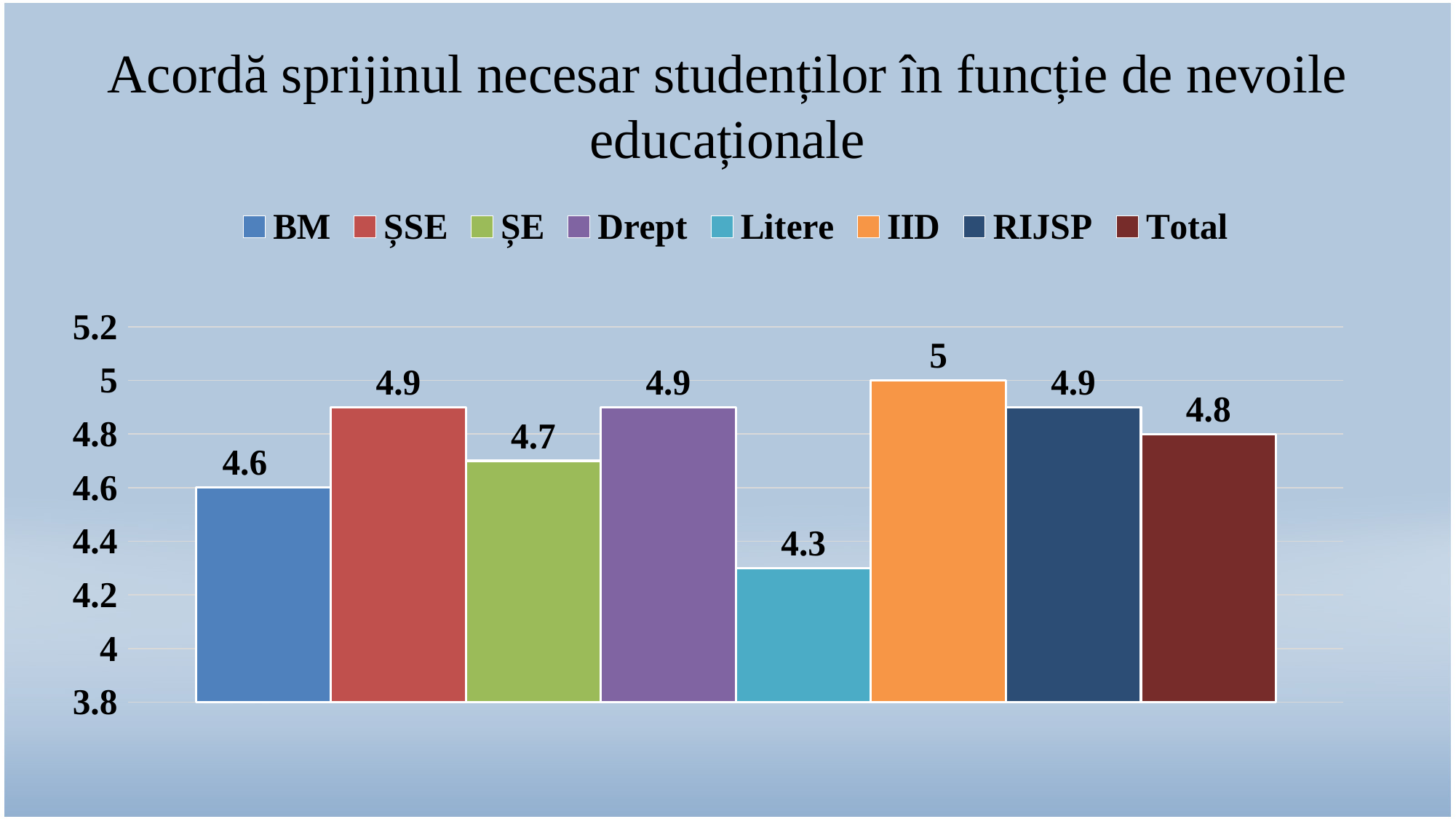
Which is larger, the value for ȘE or the value for Drept? Drept What is the value for IID? 5 What is the difference between the values for ȘSE and BM? 0.3 Is the value for Litere greater or less than 4.4? less How many series does the legend list? 8 What is the value for BM? 4.6 Which category has the highest value? IID What is the value for Litere? 4.3 Which category has the lowest value? Litere What is the difference between the values for IID and Litere? 0.7 What is the value for Total? 4.8 What kind of chart is shown on the slide? bar chart